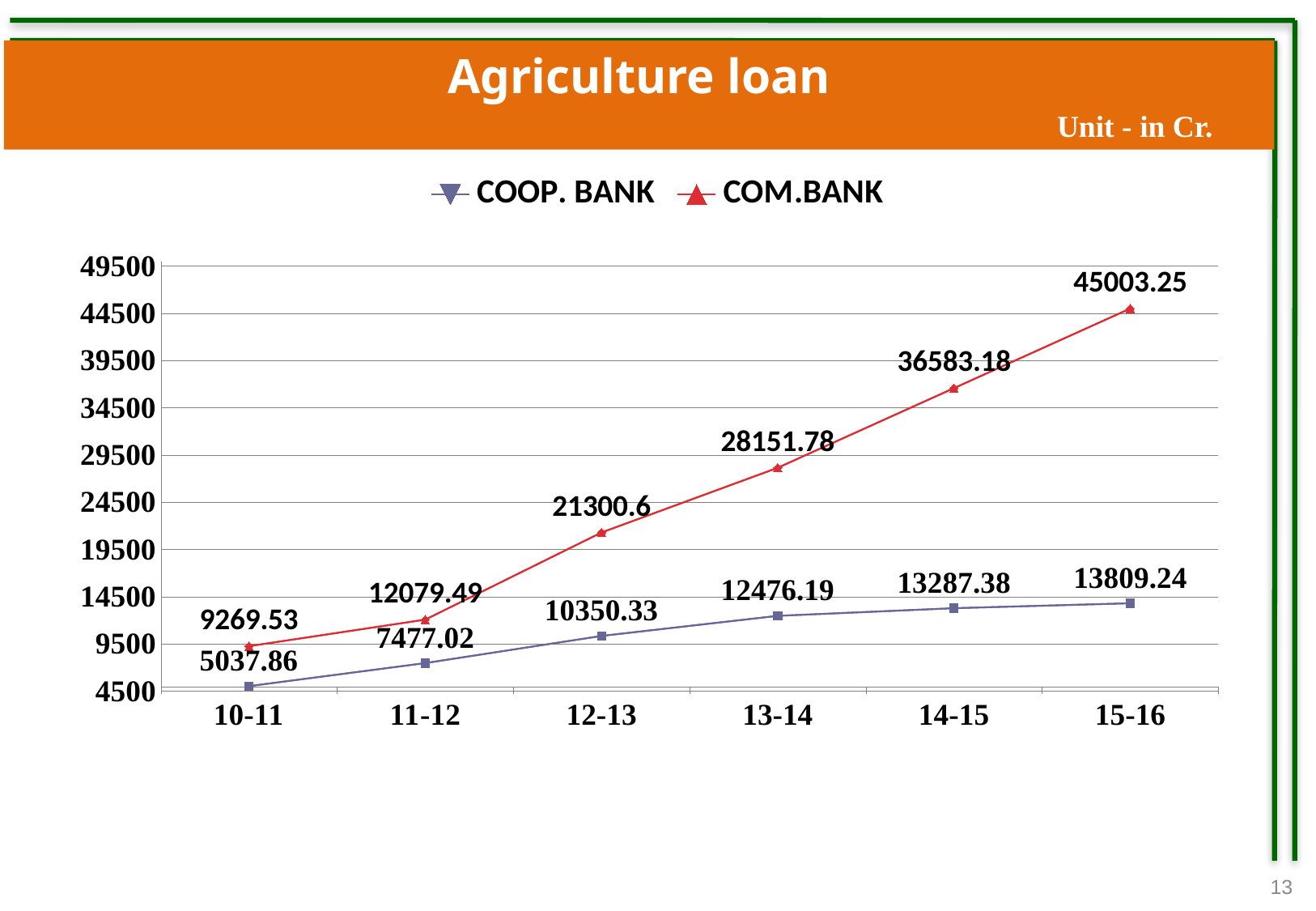
Which series has the larger value in 14-15, COOP. BANK or COM.BANK? COM.BANK How many series does the legend list? 2 What is the COM.BANK value for 13-14? 28151.78 What is the COOP. BANK value for 12-13? 10350.33 What is the difference between the COM.BANK and COOP. BANK values in 15-16? 31194.01 Do the COM.BANK values rise or fall from 10-11 to 15-16? Rise In which year is the COOP. BANK value lowest? 10-11 What is the difference between the COM.BANK and COOP. BANK values in 10-11? 4231.67 In which year is the COM.BANK value highest? 15-16 What kind of chart is shown on the slide? Line chart What is the COM.BANK value for 15-16? 45003.25 How many years are shown on the x axis? 6